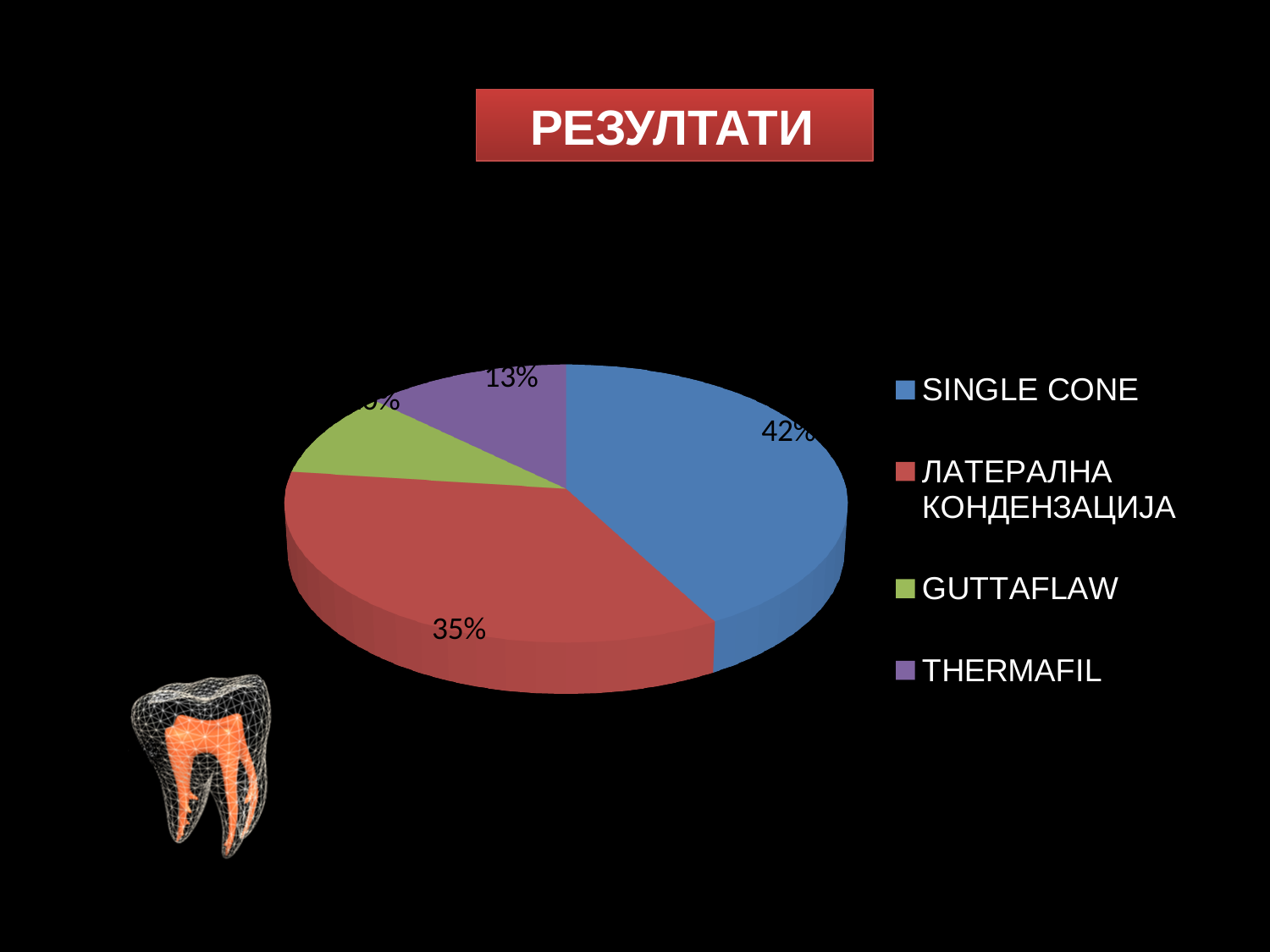
What is the difference in percentage points between SINGLE CONE and ЛАТЕРАЛНА КОНДЕНЗАЦИЈА? 7 Which category has the smallest slice of the pie chart? GUTTAFLAW What is the difference in percentage points between ЛАТЕРАЛНА КОНДЕНЗАЦИЈА and THERMAFIL? 22 What percentage of the pie chart does ЛАТЕРАЛНА КОНДЕНЗАЦИЈА represent? 35% Which category has the largest slice of the pie chart? SINGLE CONE How many categories are shown in the pie chart? 4 Which is larger, the slice for SINGLE CONE or the slice for THERMAFIL? SINGLE CONE What colour is the SINGLE CONE slice in the pie chart? Blue What kind of chart is shown on the slide? Pie chart What percentage of the pie chart does THERMAFIL represent? 13% How many entries does the legend list? 4 What percentage of the pie chart does SINGLE CONE represent? 42%